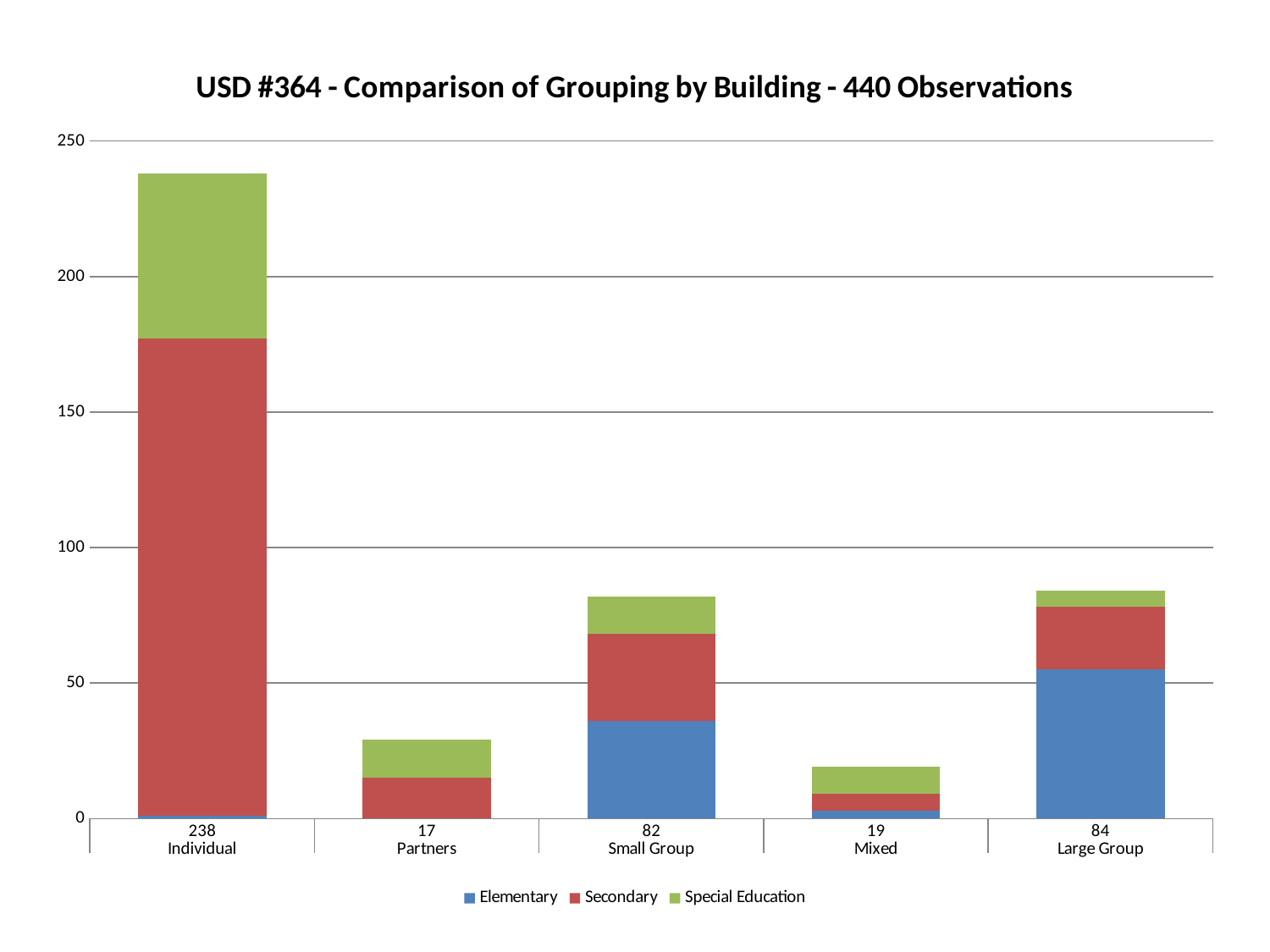
What number is printed beneath the Small Group bar on the x axis? 82 What number is printed beneath the Individual bar on the x axis? 238 What kind of chart is shown on the slide? Stacked bar chart How many series does the legend list? 3 What number is printed beneath the Large Group bar on the x axis? 84 Which series is shown in green in the legend? Special Education Is the total height of the Individual bar greater or less than 200? greater Is the Secondary segment of the Individual bar greater or less than 150? greater What is the title of the chart? USD #364 - Comparison of Grouping by Building - 440 Observations Is the total height of the Mixed bar greater or less than 50? less How many grouping categories are shown on the x axis? 5 Which grouping category has the tallest stacked bar? Individual